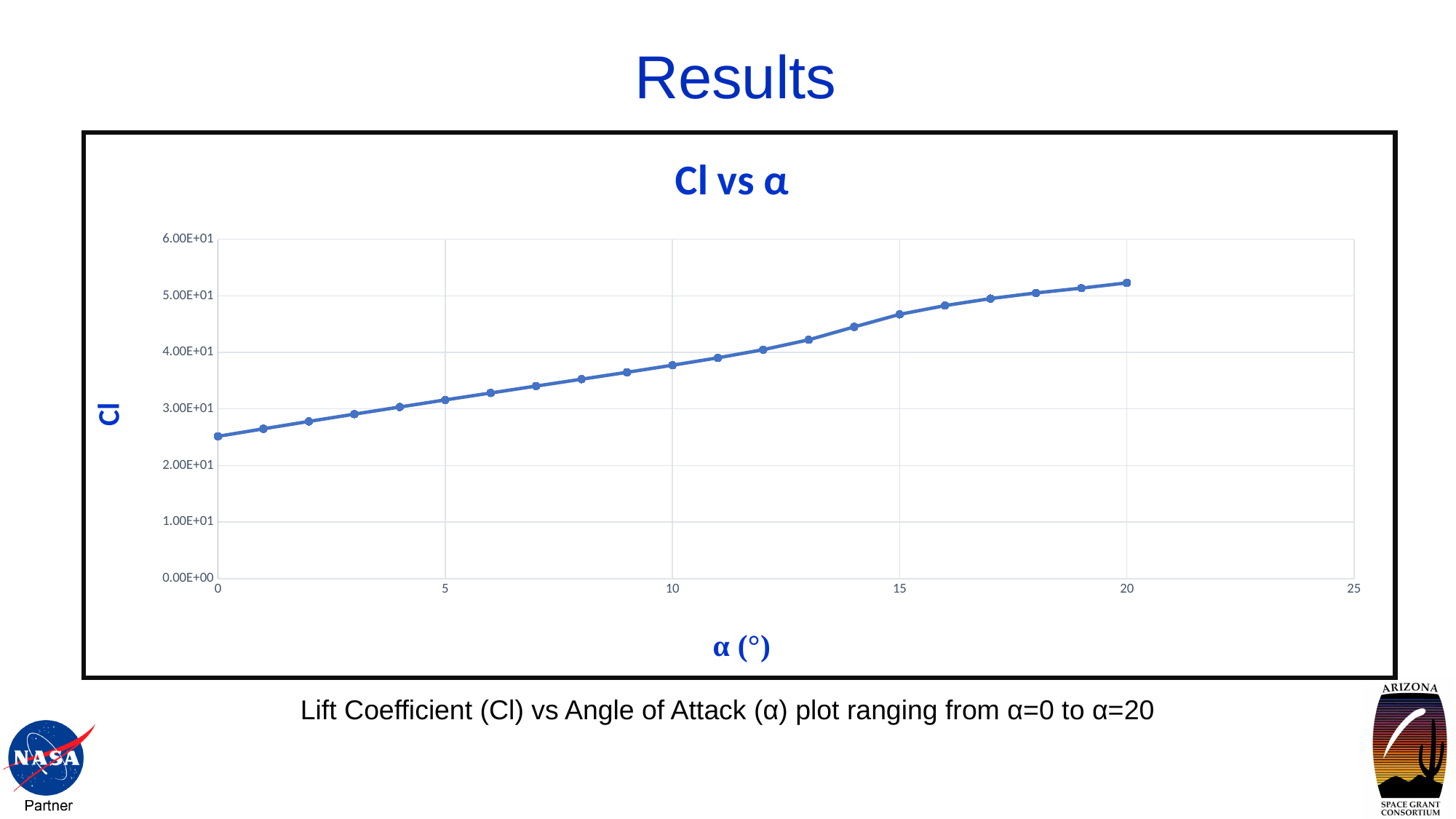
Is the value of Cl at α=20 greater or less than 5.00E+01? greater What is the label of the x axis of the chart? α (°) Is the value of Cl at α=10 greater or less than 4.00E+01? less What is the title of the chart? Cl vs α Which has the larger Cl value, α=5 or α=15? α=15 Is the value of Cl at α=0 greater or less than 2.00E+01? greater What kind of chart is shown on the slide? line chart How many data points are plotted on the Cl vs α chart? 21 At which value of α is Cl lowest? 0 At which value of α is Cl highest? 20 Does Cl rise or fall as α increases from 0 to 20? rises